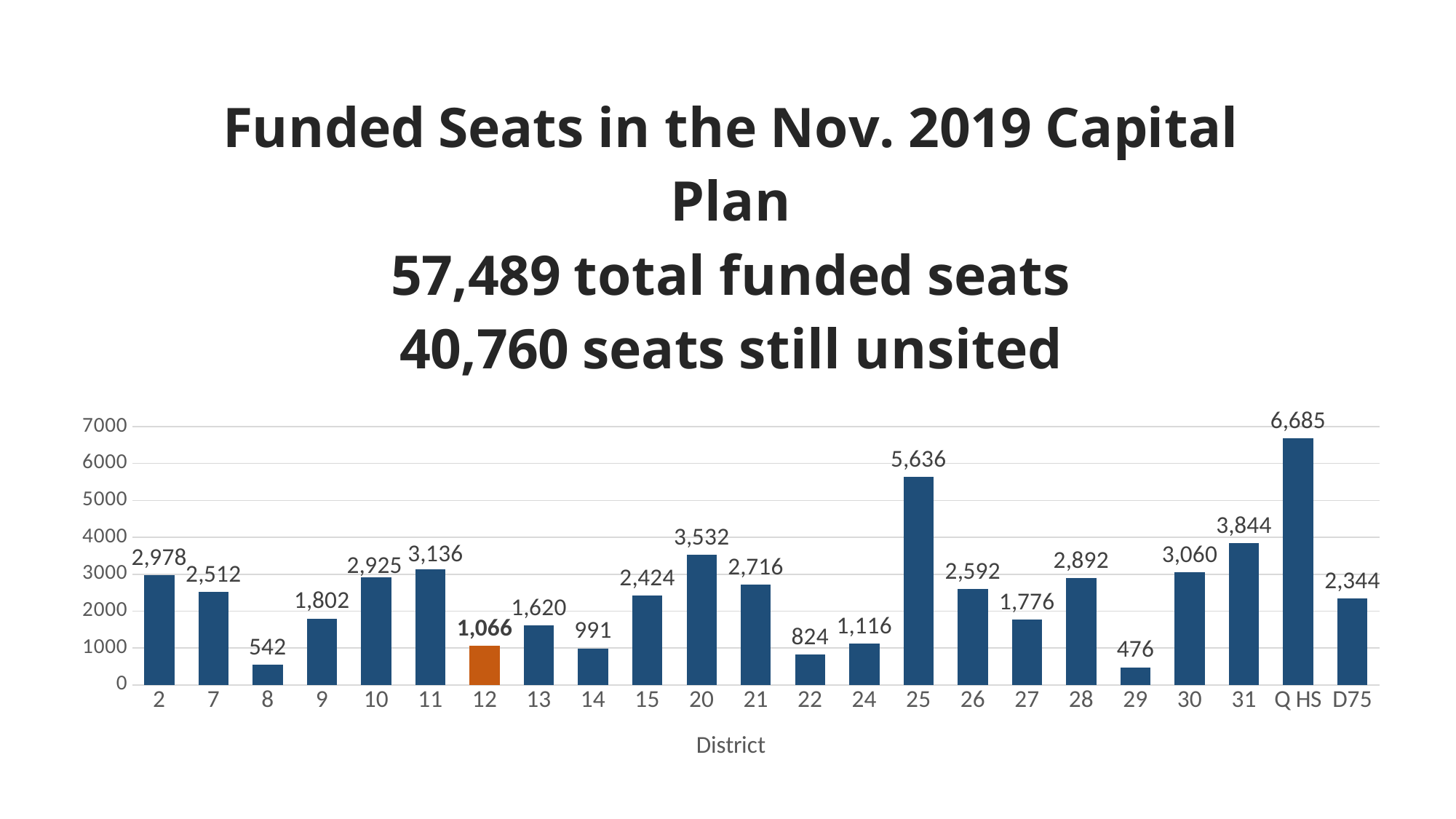
How many funded seats are shown for District 25? 5,636 Which district has the highest number of funded seats? Q HS How many funded seats does District 12 have? 1,066 What is the difference between the funded seats for Q HS and District 25? 1,049 Is the value for District 8 greater or less than 1000? less Which has more funded seats, District 20 or District 31? District 31 How many districts are shown on the x axis? 23 What kind of chart is shown on the slide? Bar chart What is the difference between the funded seats for District 13 and District 12? 554 Which district's bar is coloured orange instead of blue? 12 Which district has the lowest number of funded seats? 29 What is the value for Q HS? 6,685